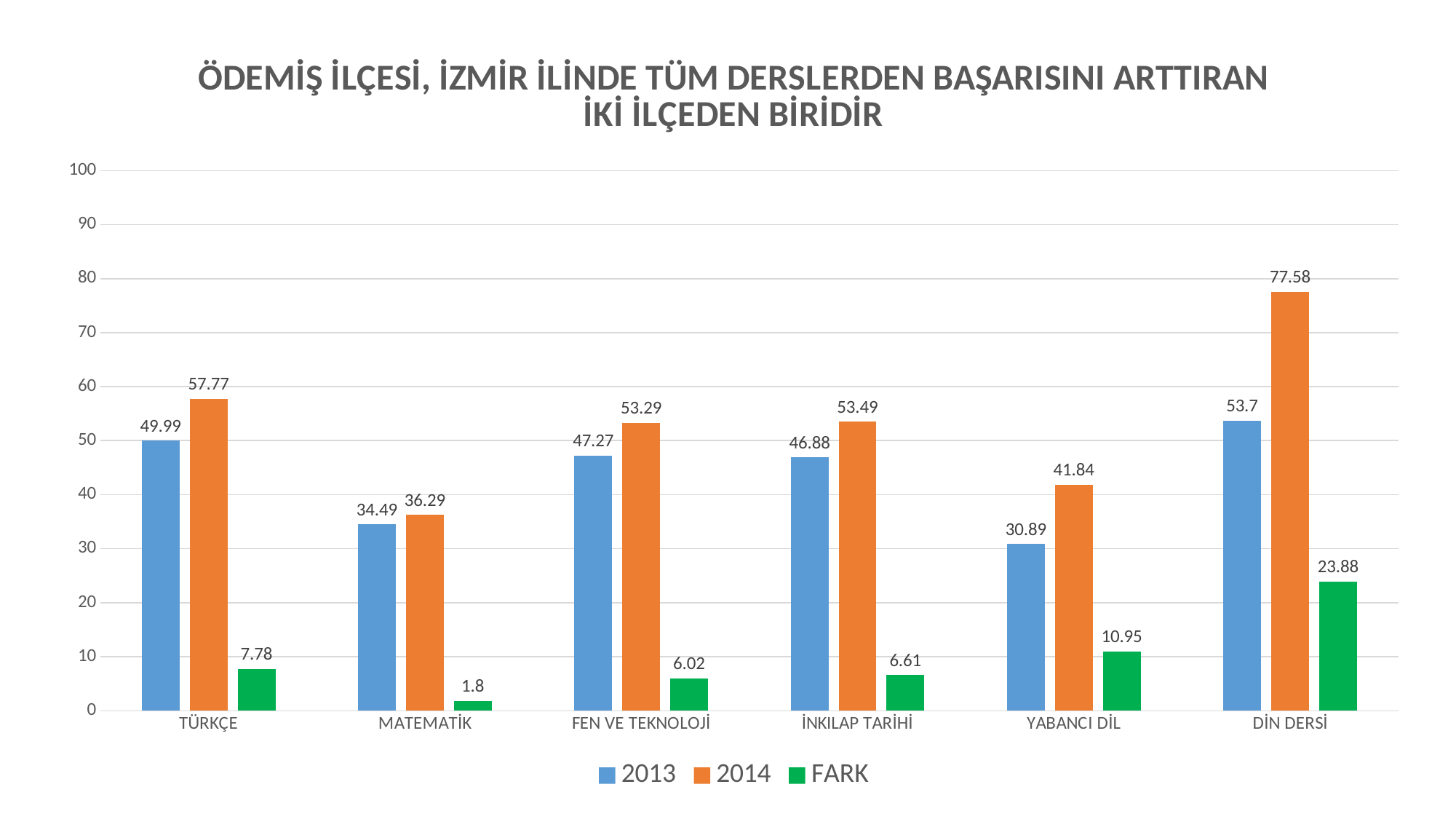
What is the 2014 value for DİN DERSİ? 77.58 What kind of chart is shown on the slide? bar chart Which is larger, the 2014 value for FEN VE TEKNOLOJİ or the 2014 value for İNKILAP TARİHİ? İNKILAP TARİHİ How many series does the legend list? 3 What is the difference between the 2014 and 2013 values for TÜRKÇE? 7.78 Which colour represents the FARK series in the legend? green How many categories are shown on the x axis? 6 Is the 2013 value for YABANCI DİL greater or less than 40? less What is the FARK value for YABANCI DİL? 10.95 What is the 2013 value for MATEMATİK? 34.49 Which category has the highest 2014 value? DİN DERSİ Which category has the lowest FARK value? MATEMATİK